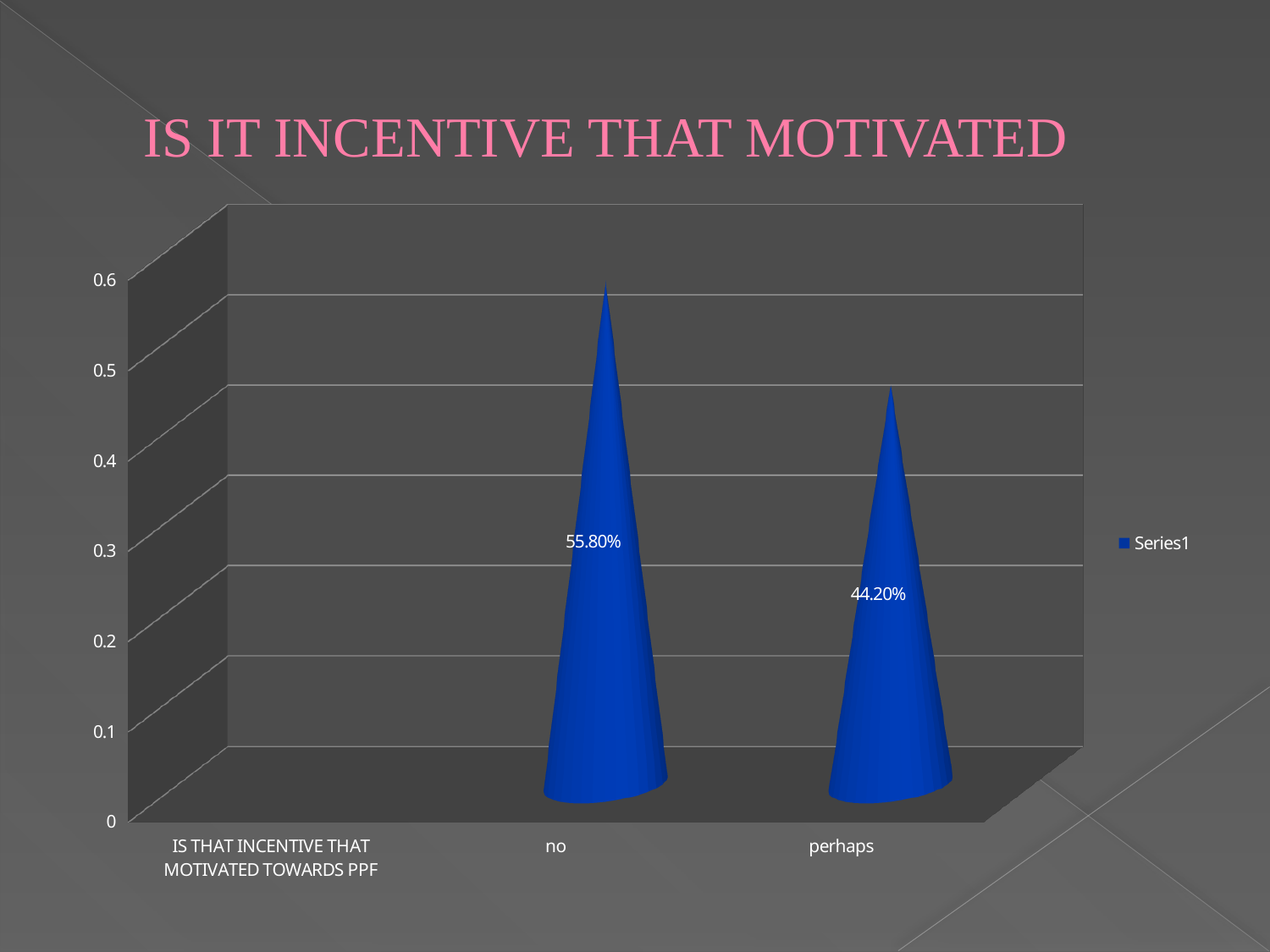
What is the difference between the values for "no" and "perhaps"? 11.60% Which is larger, the value for "no" or the value for "perhaps"? no What is the value for the category "no"? 55.80% Which category has the highest value? no What is the value for the category "perhaps"? 44.20% Is the value for "perhaps" greater or less than 0.5? less What kind of chart is shown on the slide? bar chart How many bars are plotted on the chart? 2 Which of the plotted categories has the lowest value? perhaps Is the value for "no" greater or less than 0.5? greater What is the name of the series shown in the legend? Series1 How many series does the legend list? 1